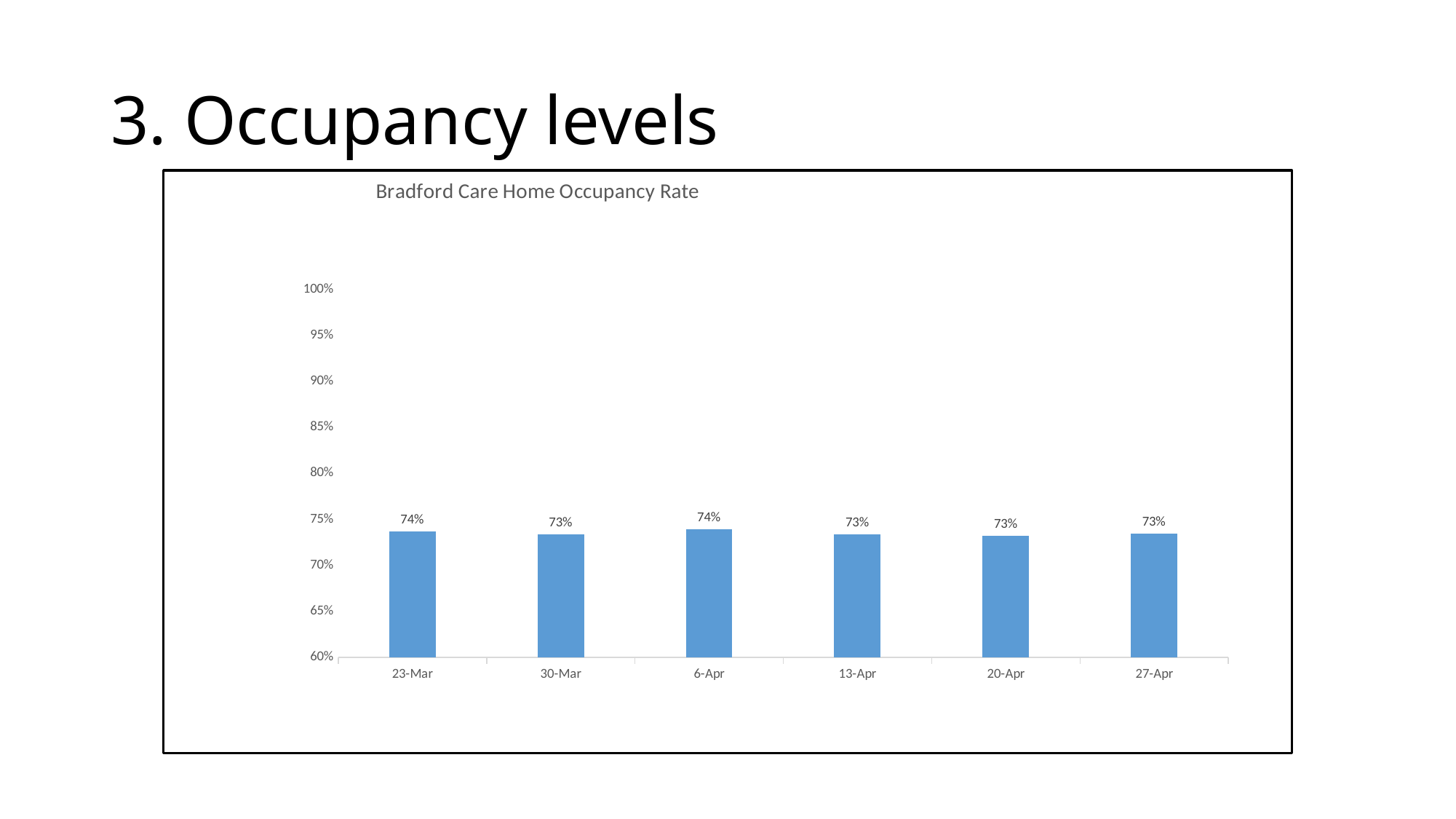
What is the occupancy rate for 30-Mar? 73% What is the difference between the occupancy rate for 23-Mar and 30-Mar? 1% Is the occupancy rate for 20-Apr greater or less than 80%? less What is the title of the chart? Bradford Care Home Occupancy Rate Is the occupancy rate for 13-Apr greater or less than 70%? greater What is the occupancy rate for 6-Apr? 74% What is the occupancy rate for 27-Apr? 73% What is the lowest value shown on the y axis of the chart? 60% What kind of chart is shown on the slide? bar chart What is the occupancy rate for 23-Mar? 74% Which has the higher occupancy rate, 6-Apr or 13-Apr? 6-Apr How many dates are shown on the x axis of the chart? 6